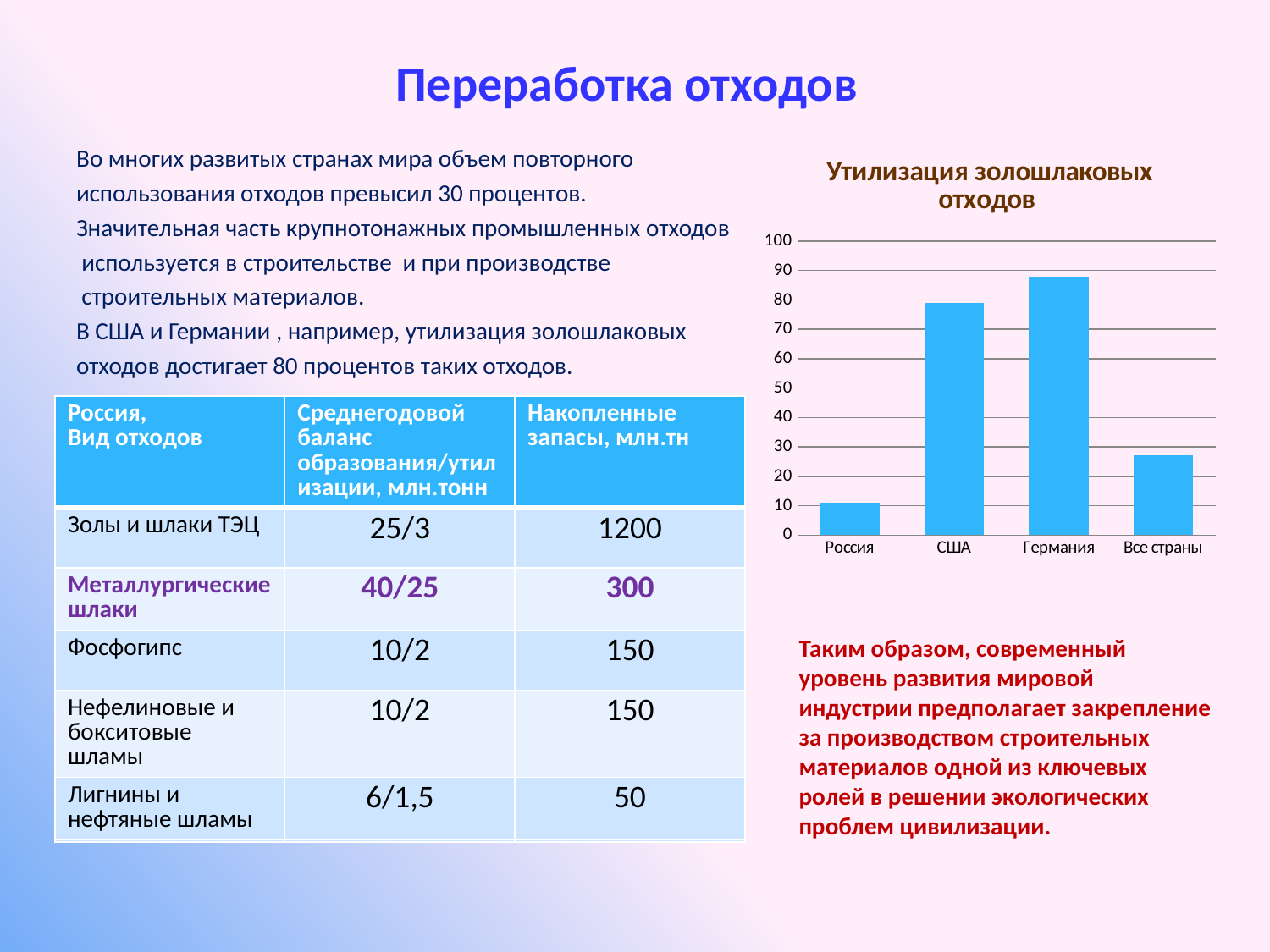
Which is larger in the chart, the value for Россия or the value for Германия? Германия Is the value for Германия greater or less than 80? greater Is the value for Россия greater or less than 20? less Is the value for Все страны greater or less than 40? less Which is larger in the chart, the value for США or the value for Все страны? США Which category has the lowest bar in the chart? Россия How many categories are shown on the x axis of the chart? 4 What kind of chart is shown on the slide? bar chart What is the title of the chart on the slide? Утилизация золошлаковых отходов Which category has the highest bar in the chart? Германия What is the highest value shown on the vertical axis of the chart? 100